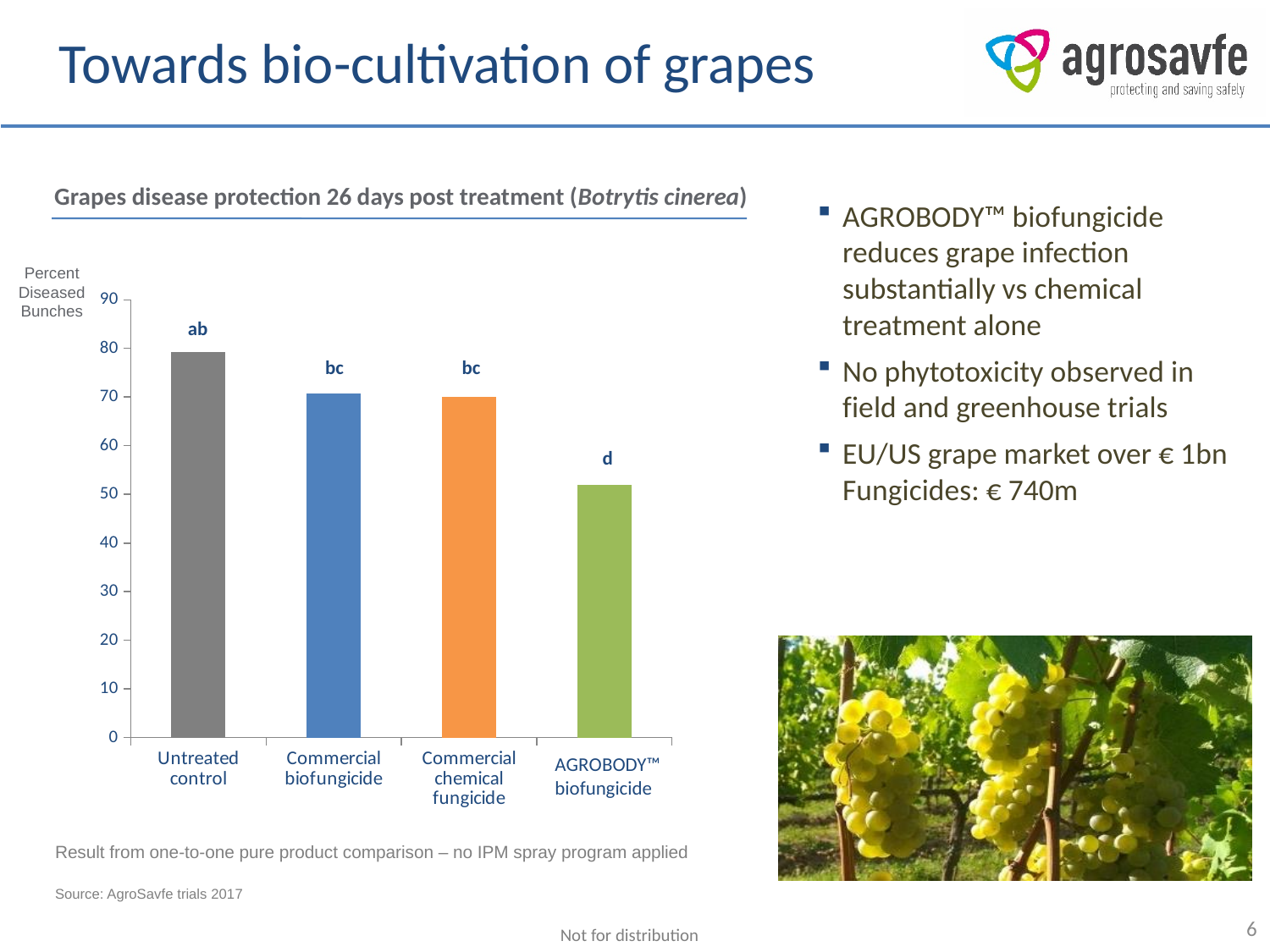
Which has a higher percent of diseased bunches: Commercial chemical fungicide or AGROBODY™ biofungicide? Commercial chemical fungicide How many treatment categories are shown on the x axis of the chart? 4 Is the value for Commercial chemical fungicide greater or less than 80? less Which has a higher percent of diseased bunches: Untreated control or AGROBODY™ biofungicide? Untreated control Which treatment has the lowest percent of diseased bunches? AGROBODY™ biofungicide Which treatment has the highest percent of diseased bunches? Untreated control Is the value for Commercial biofungicide greater or less than 60? greater What kind of chart is shown on the slide? bar chart Is the value for AGROBODY™ biofungicide greater or less than 60? less What letter label is printed above the AGROBODY™ biofungicide bar? d What is the title of the chart? Grapes disease protection 26 days post treatment (Botrytis cinerea)